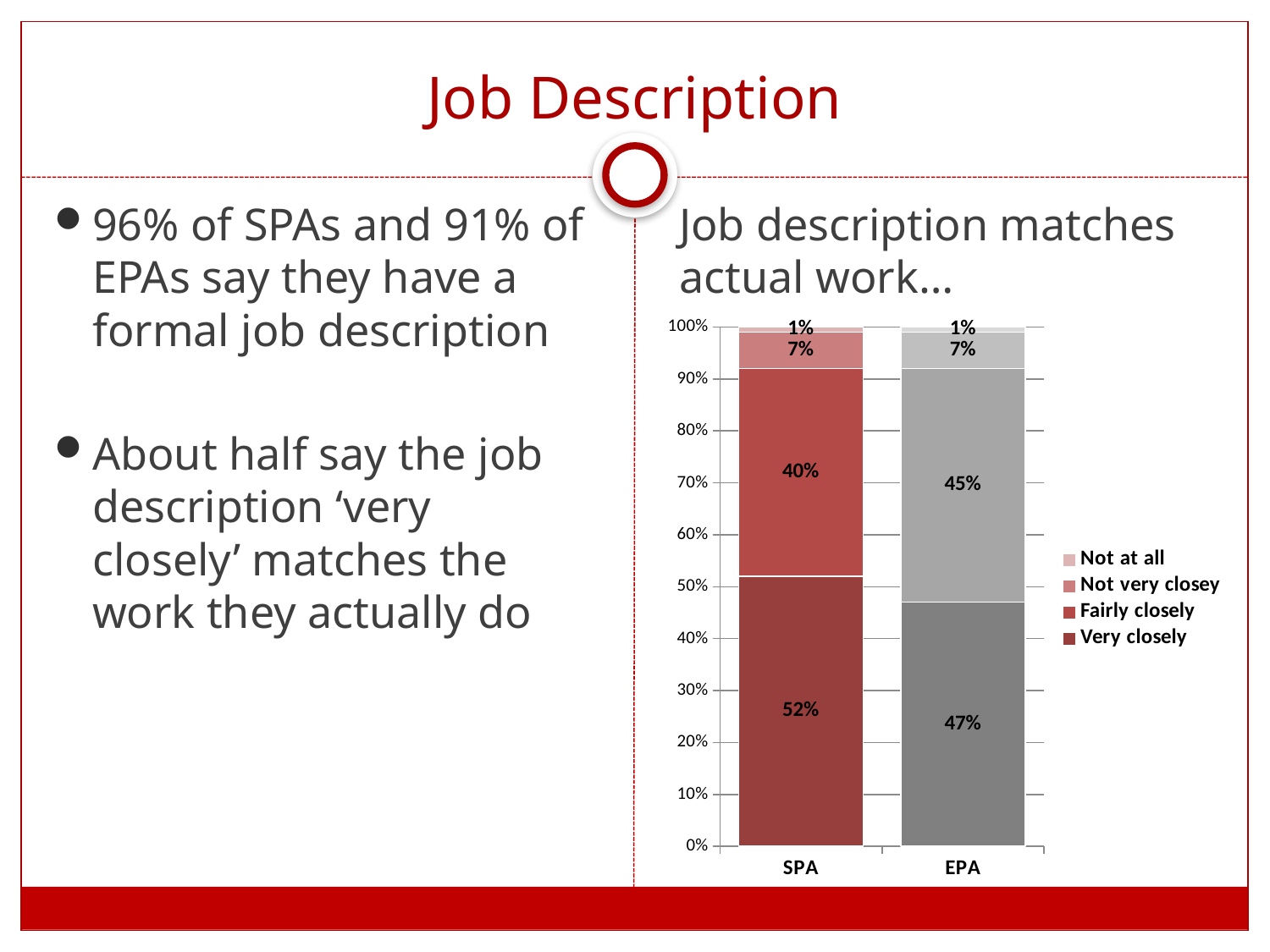
What percentage of SPAs say their job description matches their actual work 'Very closely'? 52% Which response category is the largest segment in the SPA bar? Very closely What is the difference between the 'Very closely' values for SPA and EPA? 5% What type of chart is shown on the slide? Stacked bar chart What is the 'Not very closely' value for EPA? 7% What is the difference between the 'Fairly closely' values for EPA and SPA? 5% Which group has the larger 'Very closely' share, SPA or EPA? SPA Which response category is the smallest segment in the EPA bar? Not at all How many bars (categories) are shown on the x axis of the chart? 2 How many series does the chart legend list? 4 What is the 'Not at all' value for SPA? 1% What percentage of EPAs say their job description matches their actual work 'Fairly closely'? 45%